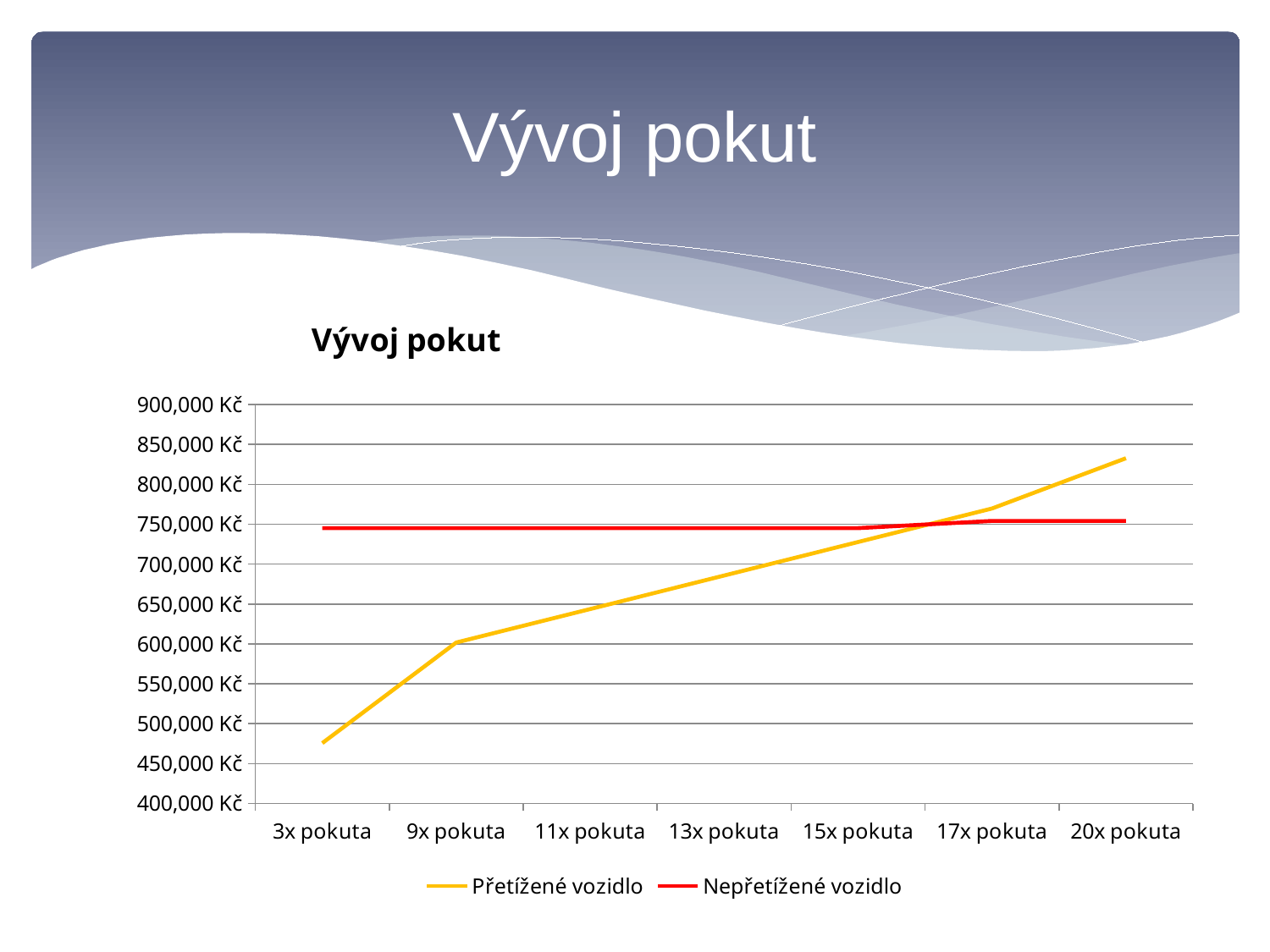
What is the title of the chart? Vývoj pokut Does the value for Přetížené vozidlo rise or fall from 3x pokuta to 20x pokuta? rise Which series is drawn in red? Nepřetížené vozidlo At which category is the value for Přetížené vozidlo lowest? 3x pokuta What kind of chart is shown on the slide? line chart Is the value for Přetížené vozidlo at 3x pokuta greater or less than 500,000 Kč? less Is the value for Nepřetížené vozidlo at 13x pokuta greater or less than 700,000 Kč? greater At which category is the value for Přetížené vozidlo highest? 20x pokuta Is the value for Přetížené vozidlo at 20x pokuta greater or less than 800,000 Kč? greater How many series does the legend list? 2 How many categories are shown on the x axis? 7 At 3x pokuta, which series has the larger value, Přetížené vozidlo or Nepřetížené vozidlo? Nepřetížené vozidlo